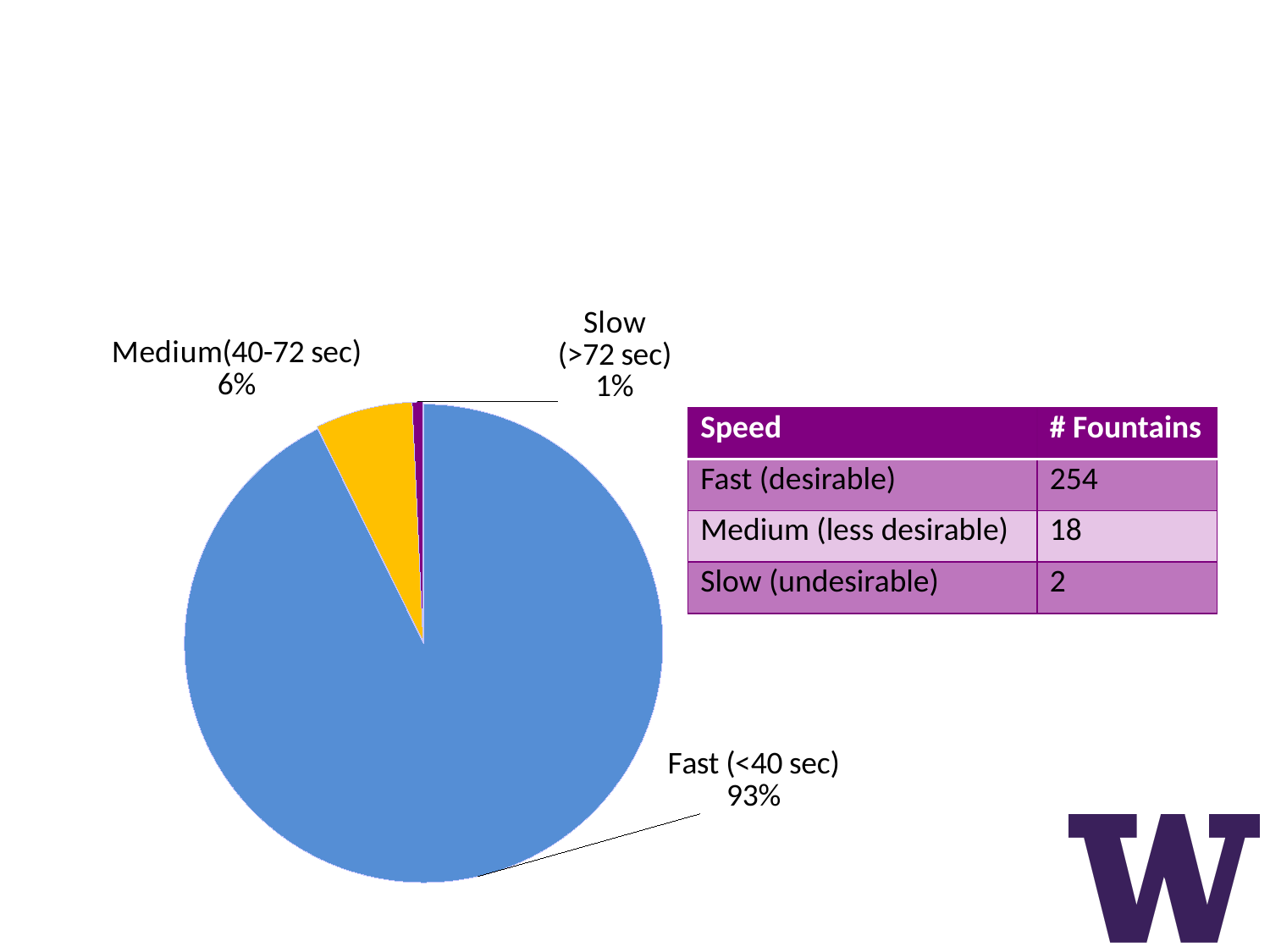
What is the difference in percentage points between the Fast (<40 sec) slice and the Medium(40-72 sec) slice? 87 What is the difference in percentage points between the Medium(40-72 sec) slice and the Slow (>72 sec) slice? 5 What kind of chart is shown on the slide? pie chart Which slice is larger, Medium(40-72 sec) or Slow (>72 sec)? Medium(40-72 sec) What share of the pie does the Medium(40-72 sec) slice represent? 6% Which category has the smallest slice of the pie? Slow (>72 sec) How many slices does the pie chart have? 3 What colour is the Fast (<40 sec) slice of the pie? blue What colour is the Medium(40-72 sec) slice of the pie? yellow What share of the pie does the Fast (<40 sec) slice represent? 93% What share of the pie does the Slow (>72 sec) slice represent? 1% Which category has the largest slice of the pie? Fast (<40 sec)